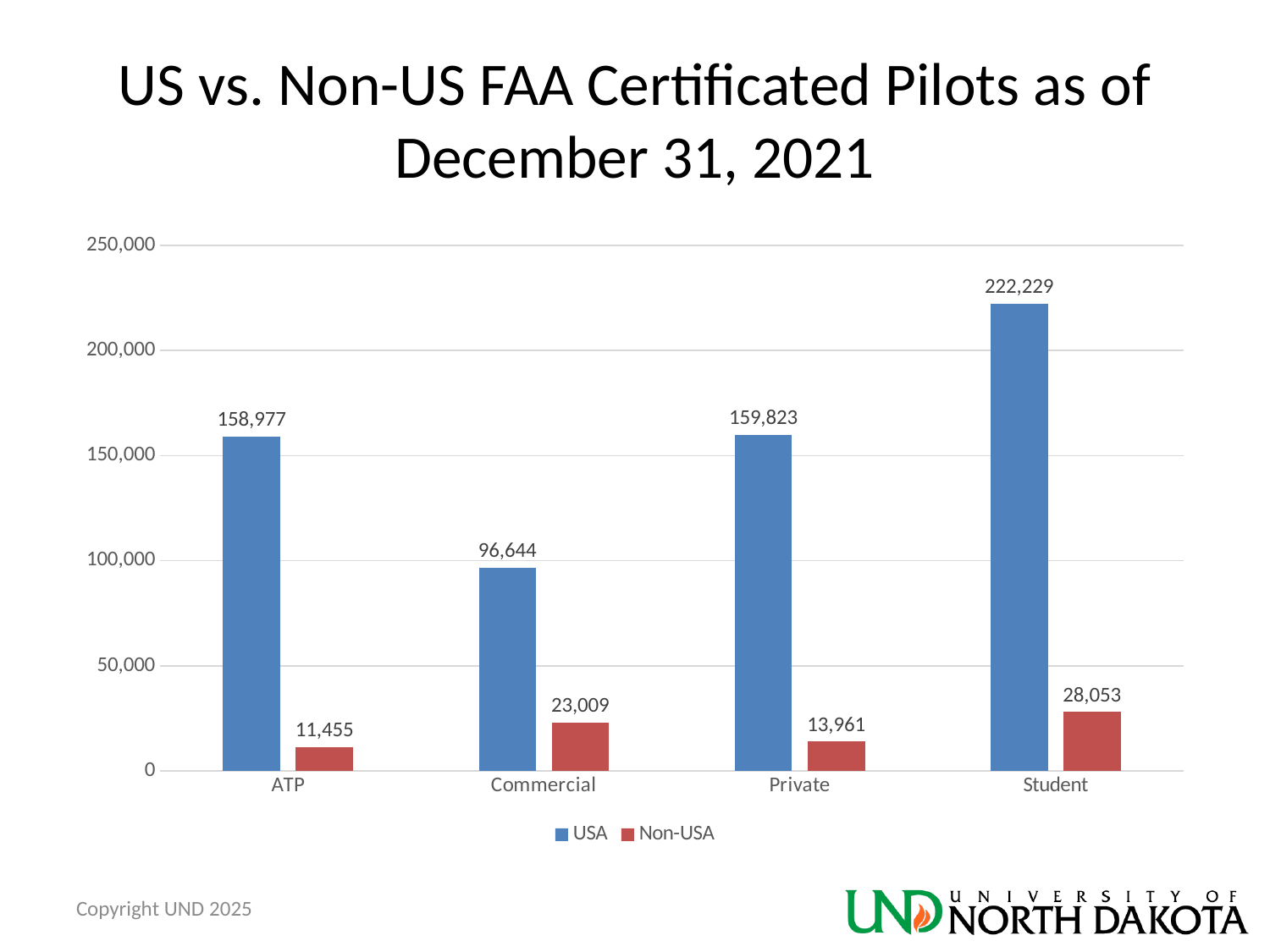
How many categories are shown on the x axis? 4 What is the Non-USA value for Commercial? 23,009 What kind of chart is shown on the slide? Bar chart How many series does the legend list? 2 Which category has the highest USA value? Student What is the difference between the USA values for Private and ATP? 846 Which category has the lowest Non-USA value? ATP What is the USA value for Student? 222,229 What is the difference between the USA and Non-USA values for Student? 194,176 Which is larger, the Non-USA value for Student or the Non-USA value for Commercial? Student What is the USA value for ATP? 158,977 What is the Non-USA value for Private? 13,961